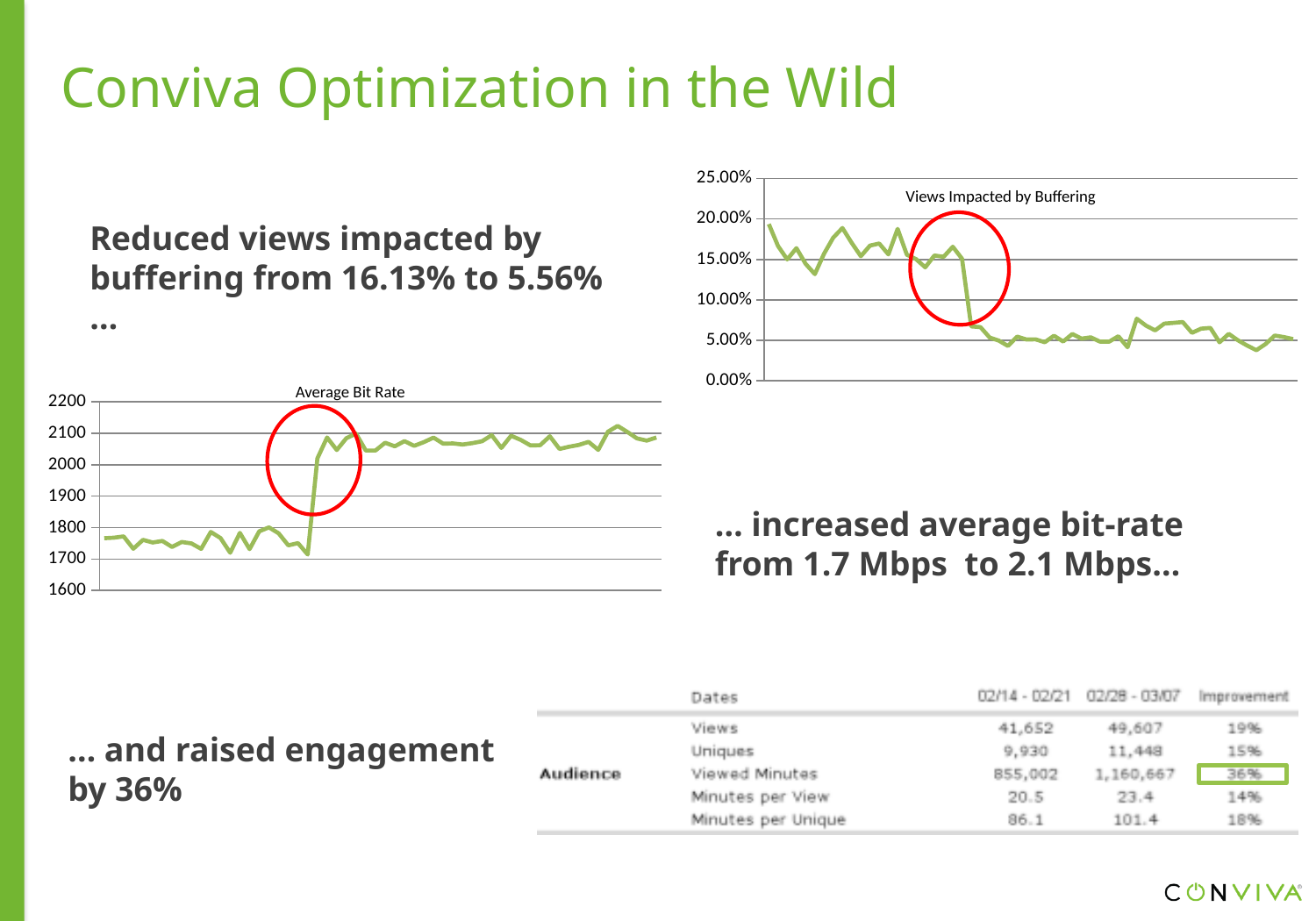
In the "Average Bit Rate" chart, do the values overall rise or fall from left to right? rise In the "Views Impacted by Buffering" chart, is the value at the left end of the line larger or smaller than the value at the right end? larger In the "Views Impacted by Buffering" chart, are the values at the right end of the line greater or less than 10.00%? less In the "Views Impacted by Buffering" chart, do the values overall rise or fall from left to right? fall In the "Average Bit Rate" chart, are the values at the right end of the line greater or less than 2000? greater In the "Average Bit Rate" chart, is the value at the left end of the line larger or smaller than the value at the right end? smaller In the "Views Impacted by Buffering" chart, is the first value of the line greater or less than 15.00%? greater What is the highest value shown on the y axis of the "Views Impacted by Buffering" chart? 25.00% What is the lowest value shown on the y axis of the "Average Bit Rate" chart? 1600 What kind of chart is the "Views Impacted by Buffering" chart? line chart What kind of chart is the "Average Bit Rate" chart? line chart